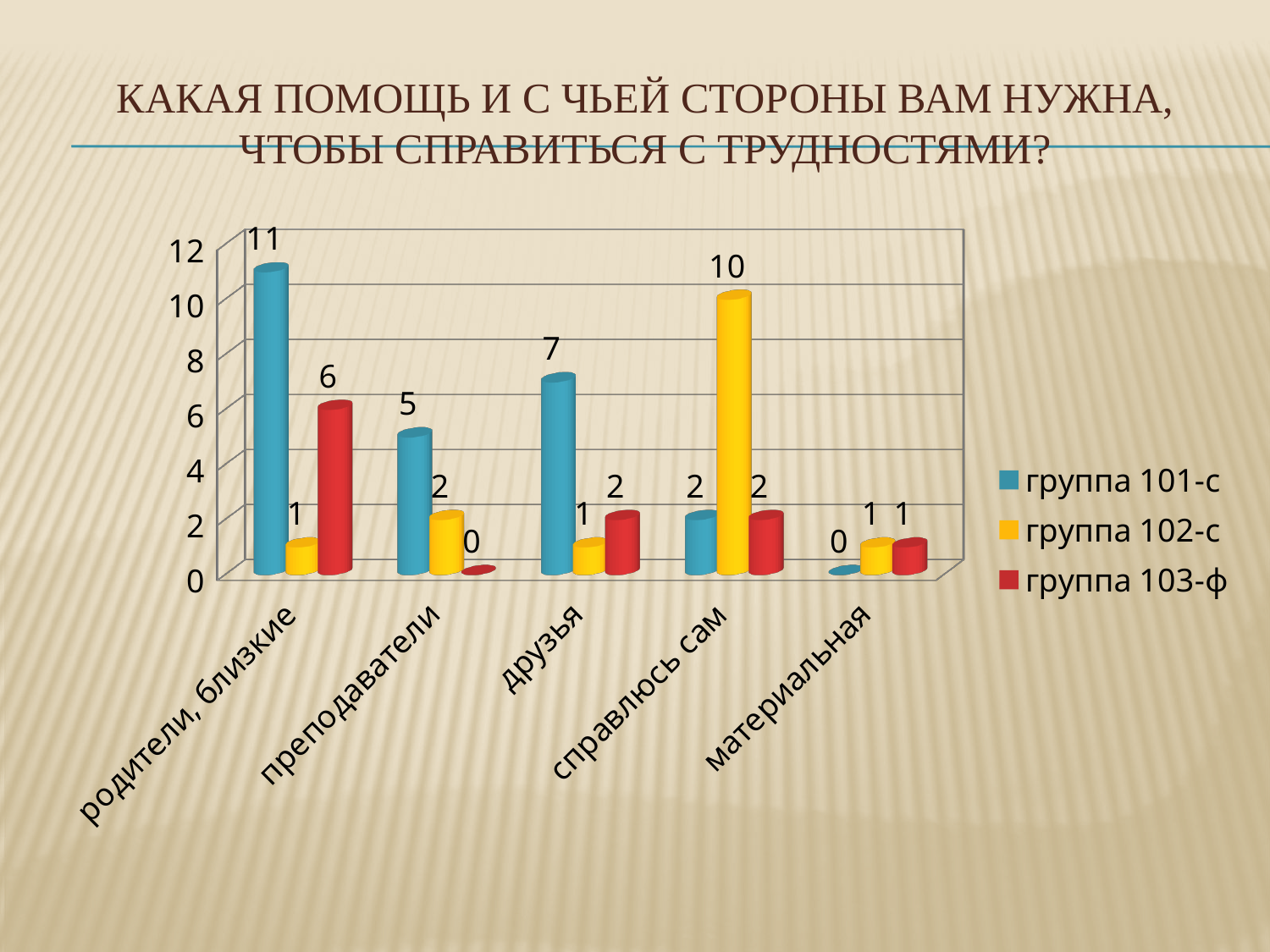
How many categories are shown on the x axis? 5 What is the value for группа 101-с in the category друзья? 7 How many series does the legend list? 3 Which colour represents группа 103-ф in the legend? red What is the value for группа 102-с in the category справлюсь сам? 10 What kind of chart is shown on the slide? bar chart What is the value for группа 103-ф in the category родители, близкие? 6 What is the value for группа 101-с in the category родители, близкие? 11 Which category has the lowest value for группа 101-с? материальная Which category has the highest value for группа 101-с? родители, близкие Which is larger in the category справлюсь сам: группа 101-с or группа 102-с? группа 102-с What is the difference between группа 101-с and группа 102-с in the category родители, близкие? 10